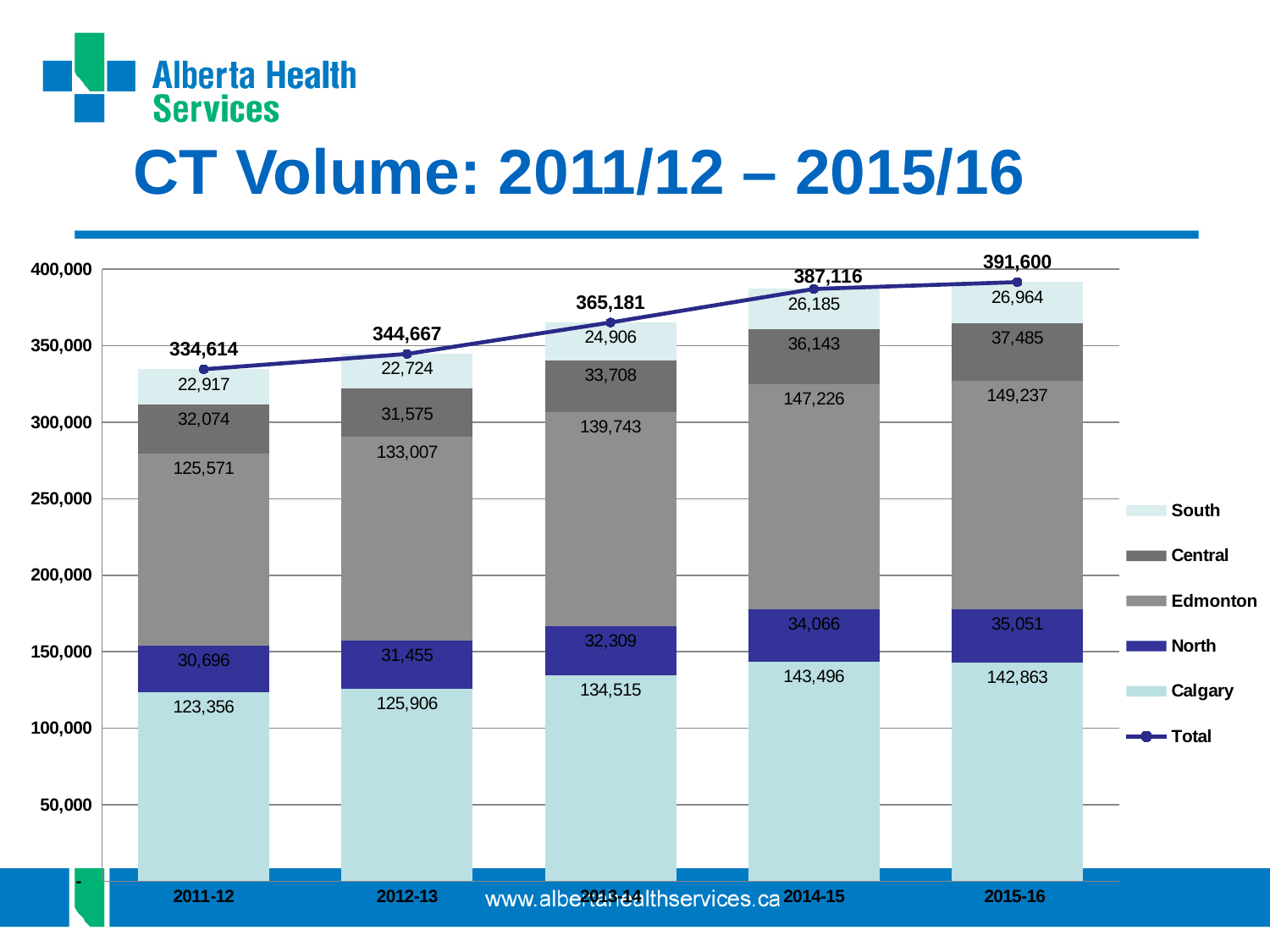
Which zone had the larger CT volume in 2014-15, Calgary or Edmonton? Edmonton What was the CT volume for Edmonton in 2013-14? 139,743 What kind of chart is shown on the slide? Stacked bar chart with a line for the total Which year had the lowest total CT volume? 2011-12 How much did the total CT volume increase from 2011-12 to 2015-16? 56,986 What was the CT volume for South in 2011-12? 22,917 How many series does the legend list? 6 Which year had the highest total CT volume? 2015-16 What was the total CT volume in 2014-15? 387,116 What was the CT volume for North in 2015-16? 35,051 Does the total CT volume rise or fall from 2011-12 to 2015-16? Rise How many fiscal years are shown on the x axis? 5